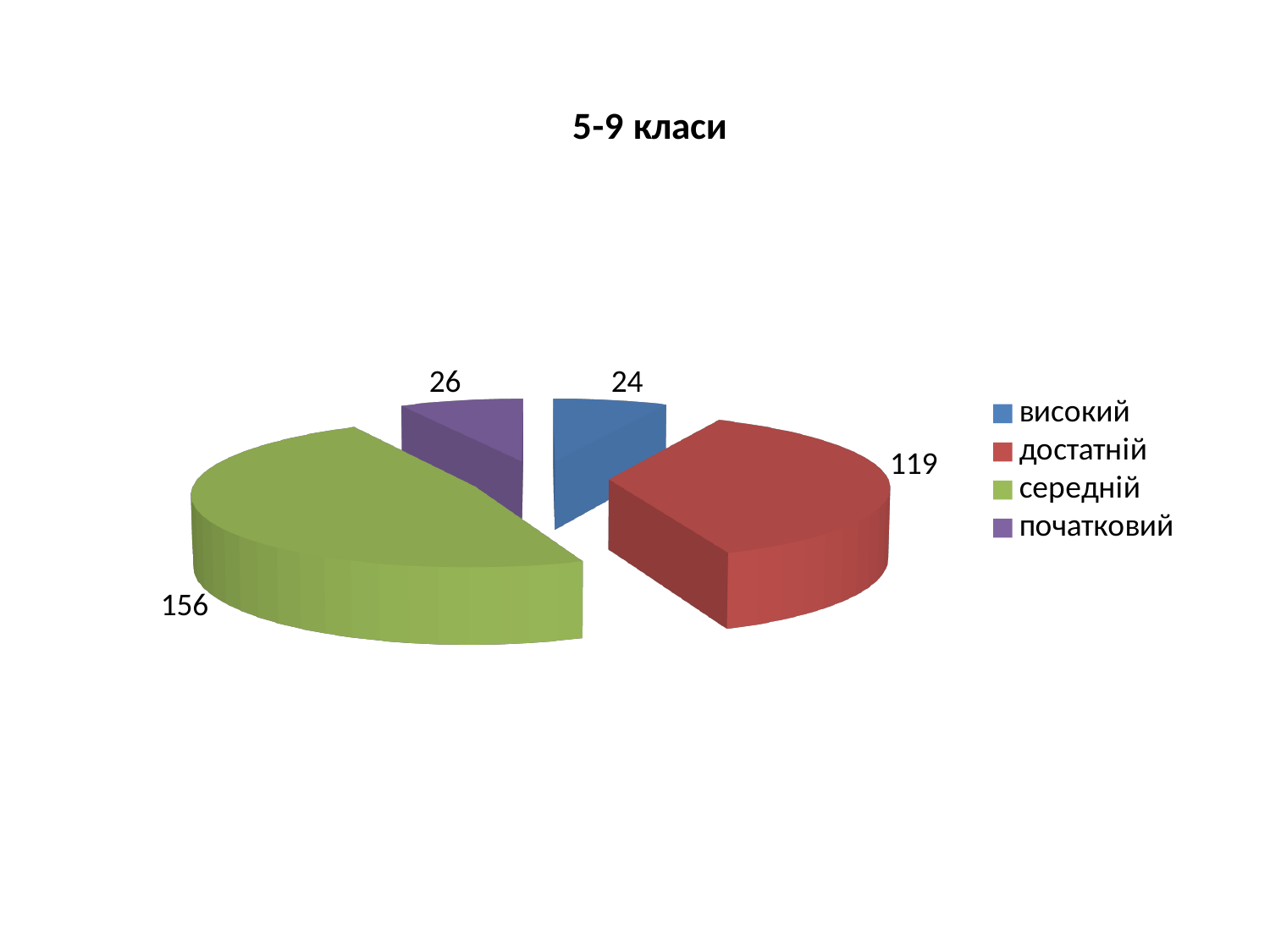
What type of chart is shown on the slide? pie chart Which is larger, the value for початковий or the value for високий? початковий What is the value for достатній? 119 What is the title of the chart? 5-9 класи Which category has the smallest slice? високий How many categories does the legend list? 4 What share of the pie does середній represent? 48% What is the value for високий? 24 What is the difference between the values for середній and достатній? 37 What is the value for середній? 156 Which category has the largest slice? середній What is the value for початковий? 26